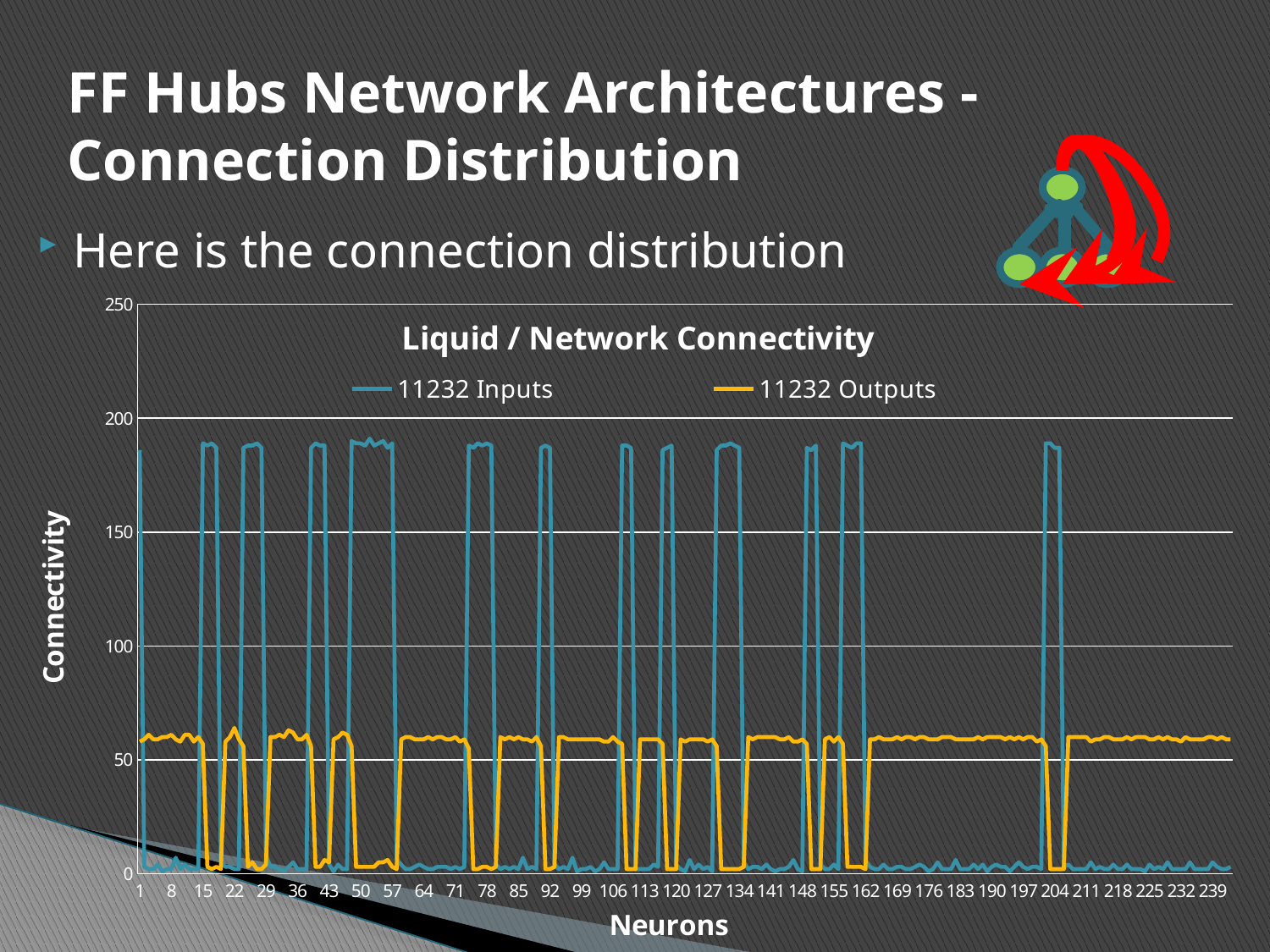
What are the two series named in the chart legend? 11232 Inputs and 11232 Outputs Is the value of the 11232 Outputs series at neuron 239 greater or less than 50? greater How many series does the chart legend list? 2 What is the title of the chart? Liquid / Network Connectivity At neuron 1, which series has the larger value, 11232 Inputs or 11232 Outputs? 11232 Inputs Is the highest value reached by the 11232 Outputs series greater or less than 100? less What type of chart is shown on the slide? Line chart Is the highest value reached by the 11232 Inputs series greater or less than 150? greater What is the maximum value shown on the Connectivity axis? 250 Which series reaches the higher peak value, 11232 Inputs or 11232 Outputs? 11232 Inputs